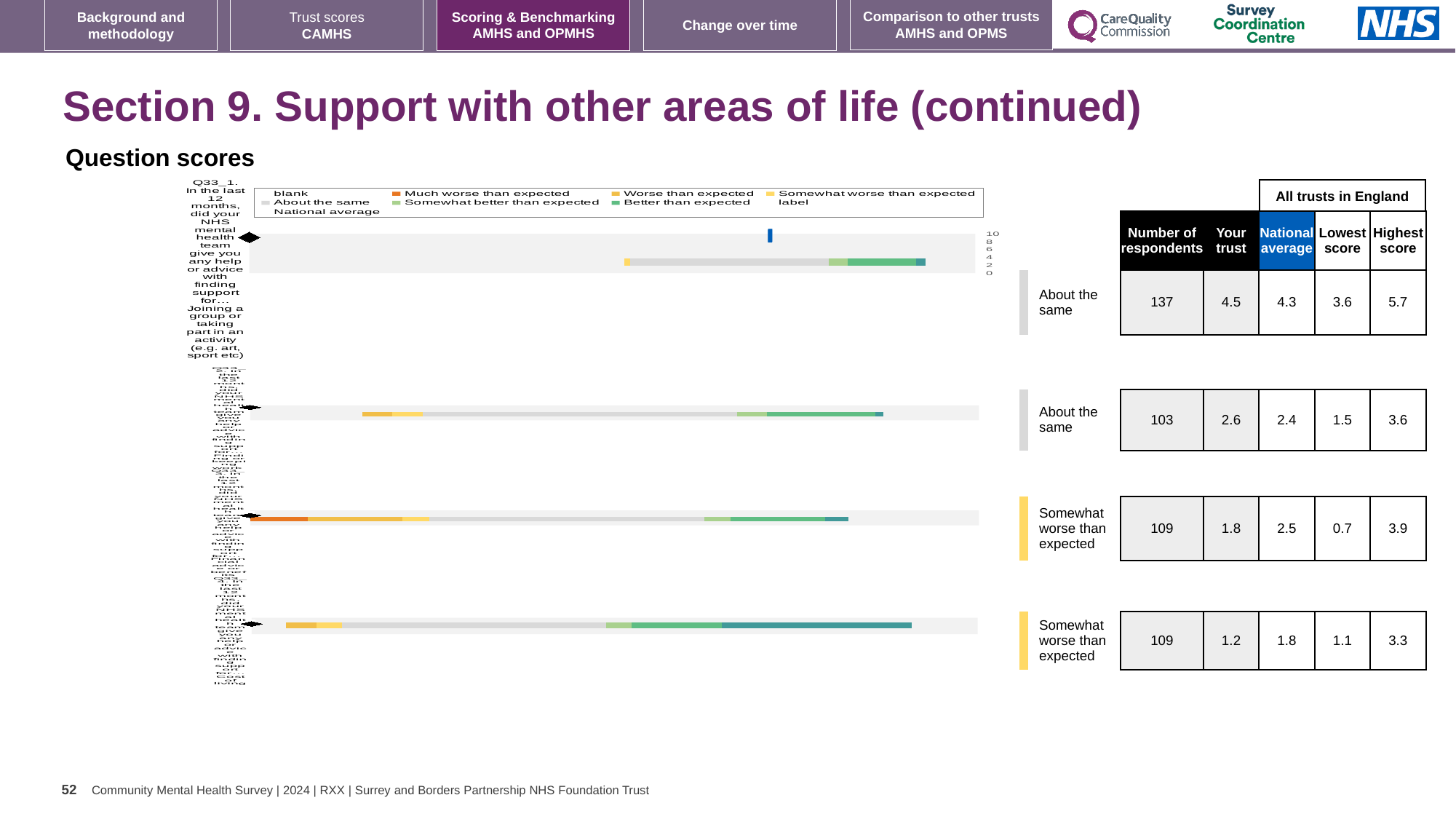
Which row of the chart has the lowest 'Your trust' score? the fourth (bottom) row, 1.2 How many respondents are listed for the top row of the chart (Q33_1)? 137 For the third row of the chart, what is the difference between the national average (2.5) and the 'Your trust' score (1.8)? 0.7 What kind of chart is shown on the slide? bar chart How many entries does the chart's legend list? 9 What is the highest score across all trusts in England for the top row of the chart (Q33_1)? 5.7 How many question rows (bars) does the chart show? 4 What benchmark label is shown for the bottom row of the chart? Somewhat worse than expected For the top row of the chart (Q33_1), which is larger: the 'Your trust' score or the national average? Your trust What is the 'Your trust' score for the top row of the chart (Q33_1, joining a group or taking part in an activity)? 4.5 What benchmark label is shown for the top row of the chart (Q33_1)? About the same What is the national average for the top row of the chart (Q33_1)? 4.3